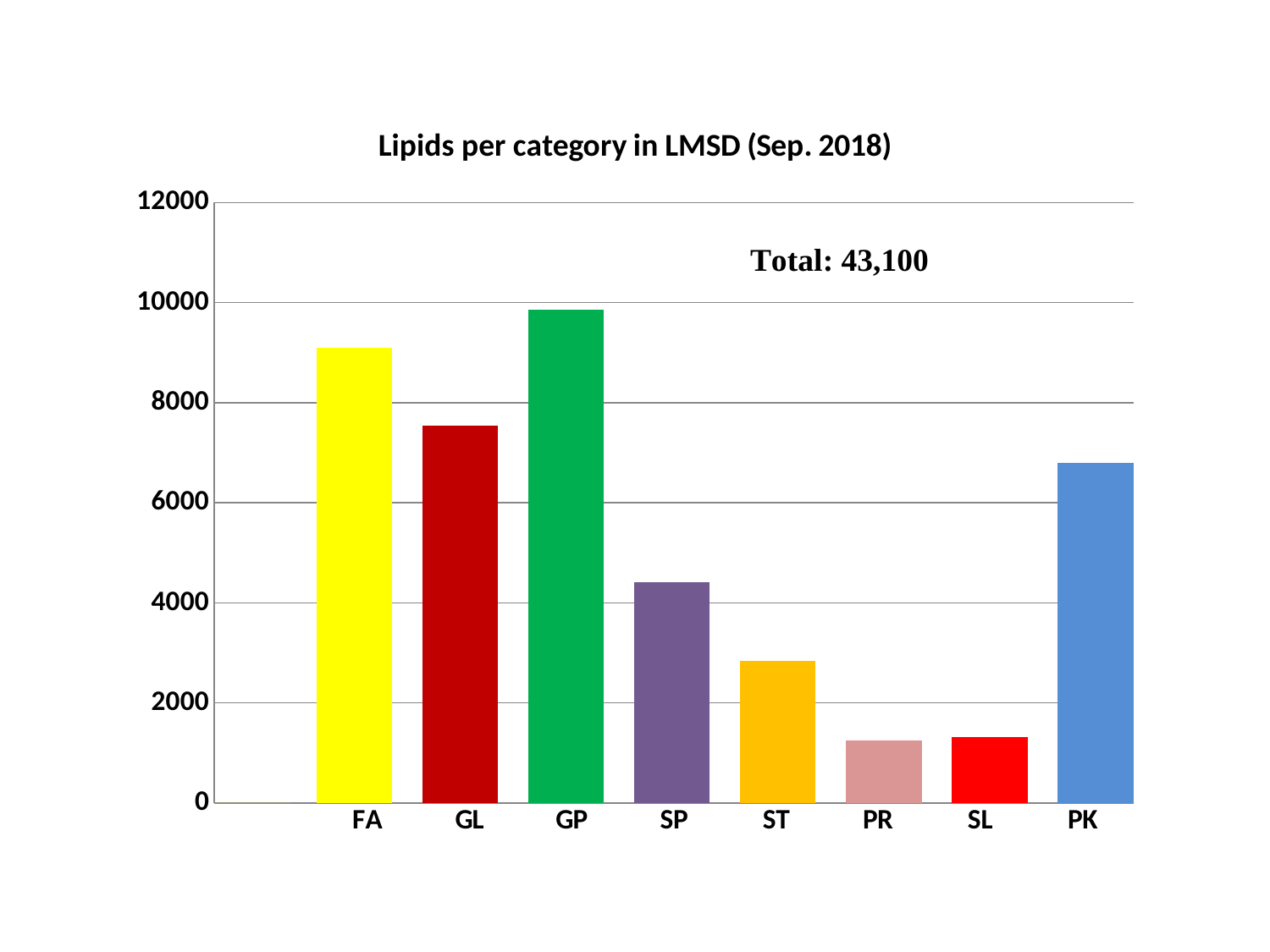
What kind of chart is shown on the slide? bar chart What total is printed on the chart? Total: 43,100 Is the value for SP greater or less than 4000? greater Which category has the highest value? GP Is the value for PK greater or less than 6000? greater How many categories are plotted on the x axis? 8 Which is larger, the value for FA or the value for GL? FA What is the title of the chart? Lipids per category in LMSD (Sep. 2018) Is the value for ST greater or less than 2000? greater